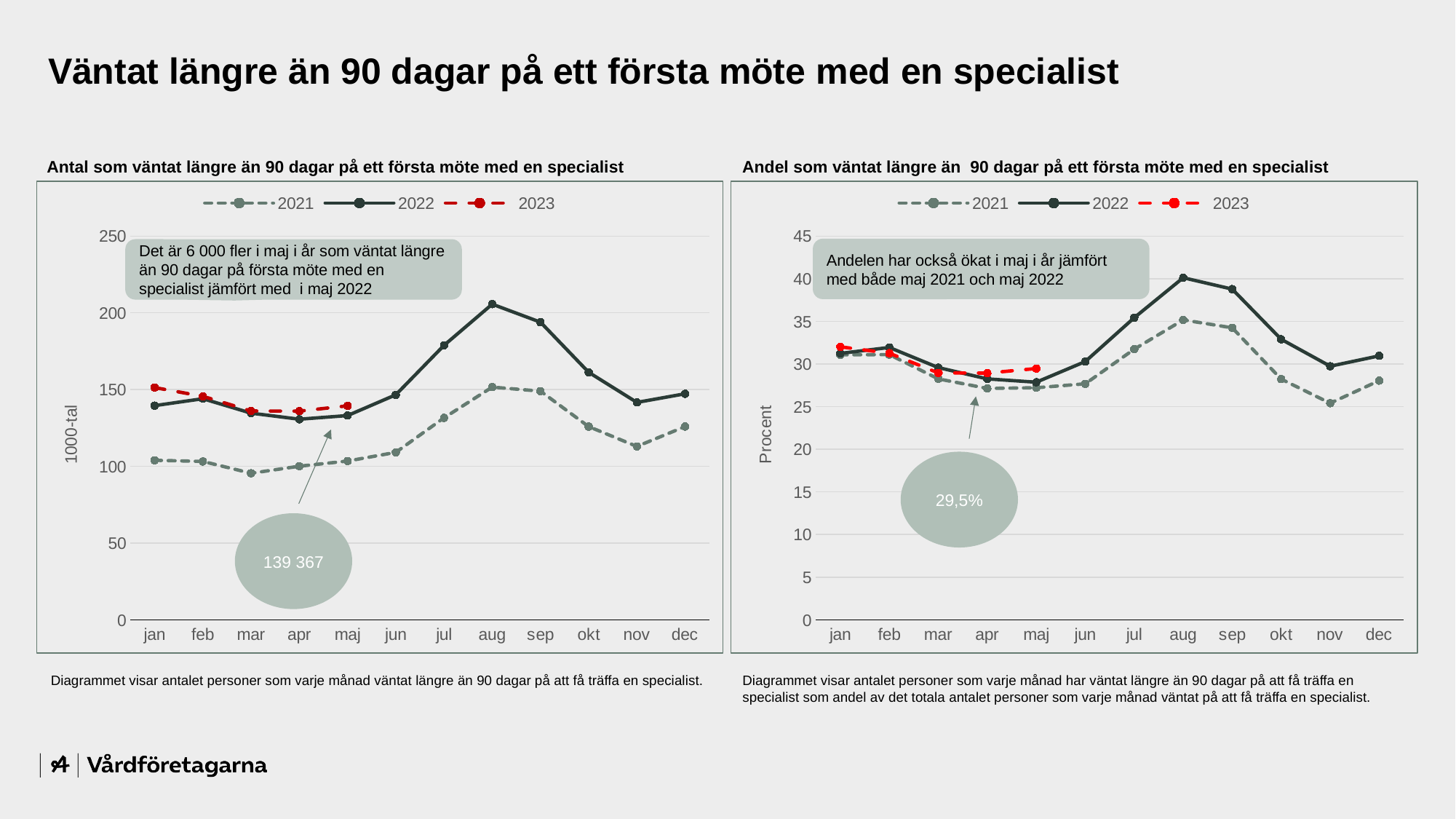
In the left chart, 'Antal som väntat längre än 90 dagar...', what value does the callout give for maj 2023? 139 367 In the left chart, 'Antal som väntat längre än 90 dagar...', in which month does the 2021 series reach its lowest value? mar In the right chart, 'Andel som väntat längre än 90 dagar...', in which month does the 2022 series reach its highest value? aug What kind of chart is the left chart, 'Antal som väntat längre än 90 dagar på ett första möte med en specialist'? Line chart In the right chart, 'Andel som väntat längre än 90 dagar...', which is larger in maj: the 2023 value or the 2022 value? 2023 In the right chart, 'Andel som väntat längre än 90 dagar...', what value does the callout give for maj 2023? 29,5% In the right chart, 'Andel som väntat längre än 90 dagar...', is the 2021 value for nov greater or less than 30? less How many series does the legend of the right chart, 'Andel som väntat längre än 90 dagar på ett första möte med en specialist', list? 3 In the left chart, 'Antal som väntat längre än 90 dagar...', is the 2022 value for aug greater or less than 200? greater In the left chart, 'Antal som väntat längre än 90 dagar...', does the 2022 series rise or fall from maj to aug? Rise How many months are shown on the x axis of the left chart, 'Antal som väntat längre än 90 dagar...'? 12 In the left chart, 'Antal som väntat längre än 90 dagar...', in which month does the 2022 series reach its highest value? aug